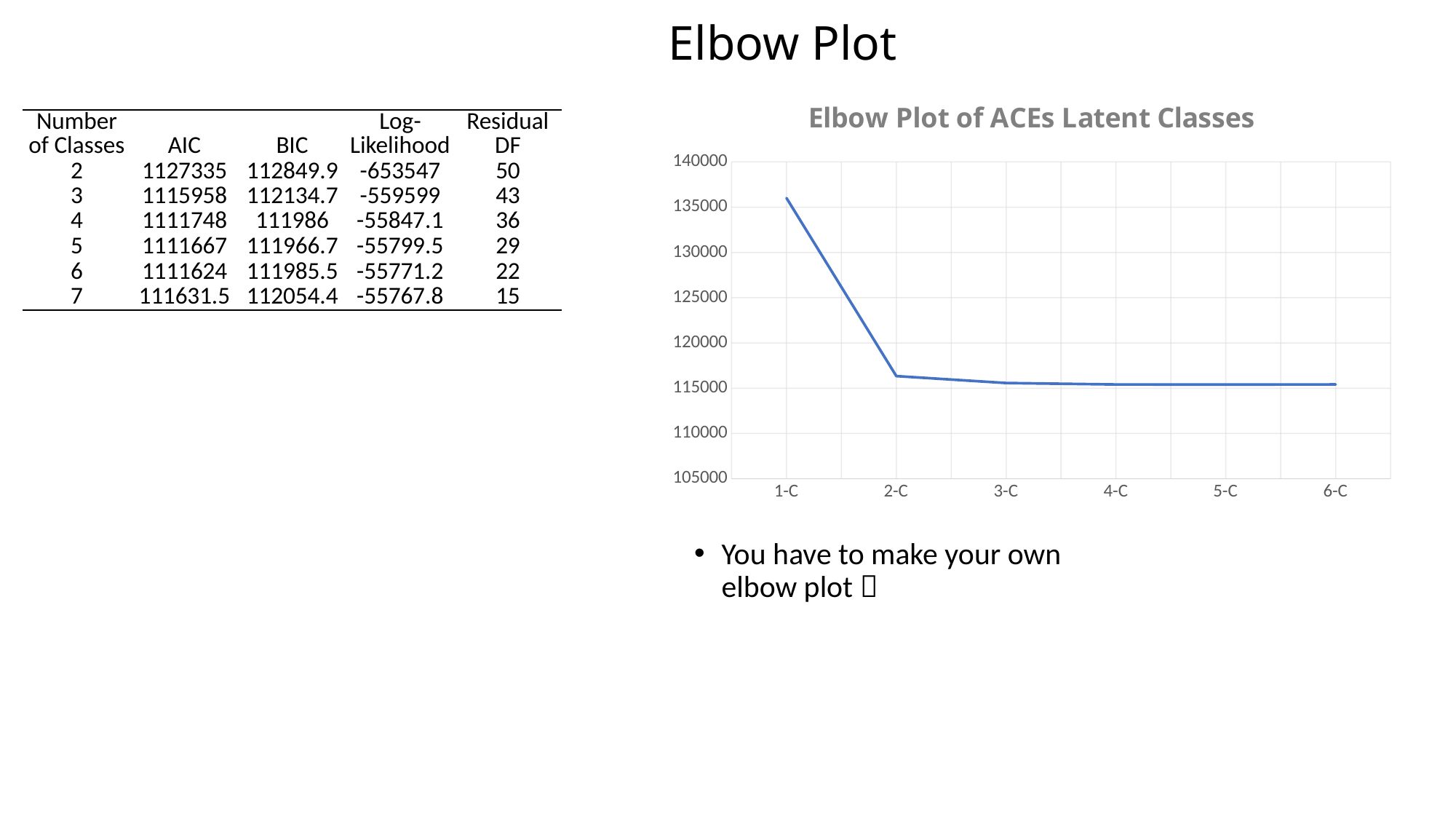
What is the title of the chart on the slide? Elbow Plot of ACEs Latent Classes What colour is the line in the Elbow Plot of ACEs Latent Classes? Blue Which category has the highest value in the Elbow Plot of ACEs Latent Classes? 1-C Which is larger in the Elbow Plot of ACEs Latent Classes, the value for 1-C or the value for 2-C? 1-C Is the value for 1-C greater or less than 130000? greater Is the value for 2-C greater or less than 120000? less What kind of chart is the Elbow Plot of ACEs Latent Classes? Line chart Do the values in the Elbow Plot of ACEs Latent Classes rise or fall from 1-C to 6-C? Fall How many points are plotted along the x axis of the Elbow Plot of ACEs Latent Classes? 6 Which is larger in the Elbow Plot of ACEs Latent Classes, the value for 2-C or the value for 6-C? 2-C Is the value for 6-C greater or less than 120000? less